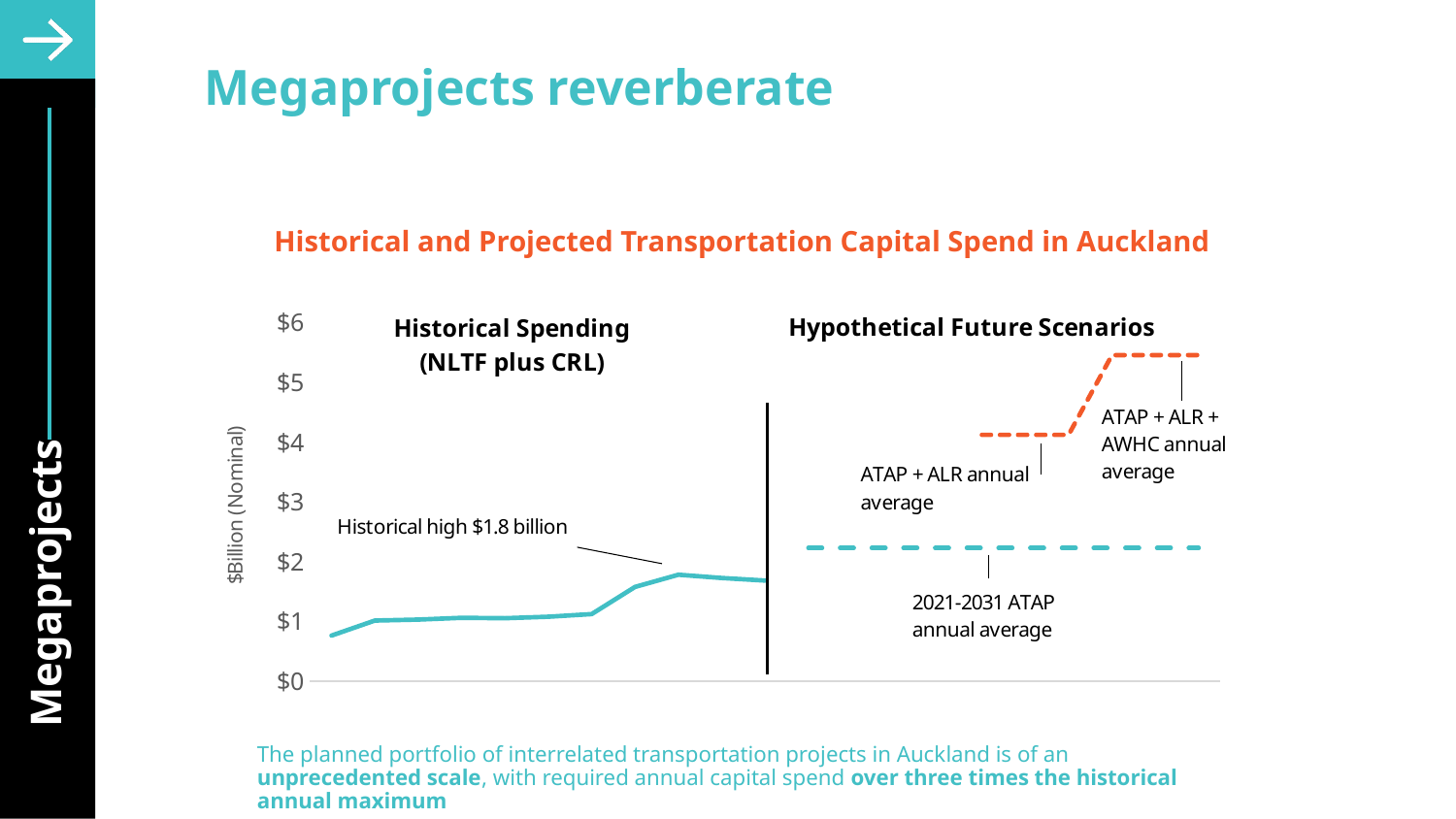
Which hypothetical future scenario has the highest annual average spend? ATAP + ALR + AWHC annual average What kind of chart is shown on the slide? line chart What is the title of the chart? Historical and Projected Transportation Capital Spend in Auckland Is the 2021-2031 ATAP annual average greater or less than $3 billion? less Is the ATAP + ALR annual average greater or less than $3 billion? greater What value does the chart give for the historical high in spending? $1.8 billion Which is higher, the ATAP + ALR annual average or the 2021-2031 ATAP annual average? ATAP + ALR annual average How many hypothetical future scenarios are plotted on the chart? 3 What is the label on the vertical axis of the chart? $Billion (Nominal) Does the historical spending line generally rise or fall from left to right? rise Is the ATAP + ALR + AWHC annual average greater or less than $5 billion? greater Which hypothetical future scenario has the lowest annual average spend? 2021-2031 ATAP annual average